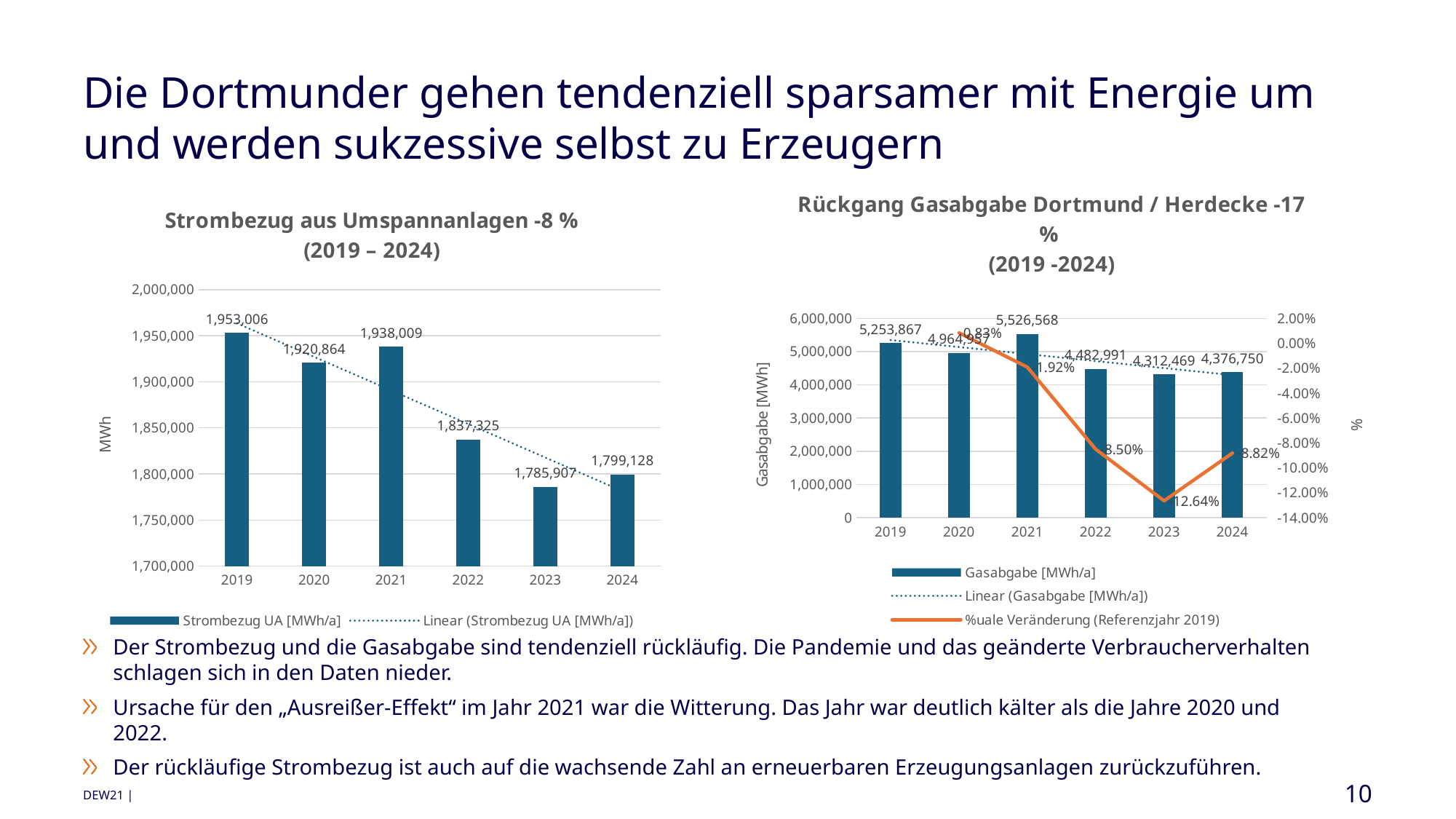
In the left chart 'Strombezug aus Umspannanlagen', what is the value for 2023? 1,785,907 In the left chart 'Strombezug aus Umspannanlagen', which year has the lowest value? 2023 In the right chart 'Rückgang Gasabgabe Dortmund / Herdecke', which year has the highest Gasabgabe bar? 2021 In the left chart 'Strombezug aus Umspannanlagen', what is the difference between the 2019 and 2024 values? 153,878 In the left chart 'Strombezug aus Umspannanlagen', which year has the highest value? 2019 In the right chart 'Rückgang Gasabgabe Dortmund / Herdecke', what is the Gasabgabe value for 2021? 5,526,568 How many series does the legend of the right chart 'Rückgang Gasabgabe Dortmund / Herdecke' list? 3 In the right chart 'Rückgang Gasabgabe Dortmund / Herdecke', is the Gasabgabe bar for 2022 or for 2024 larger? 2022 In the left chart 'Strombezug aus Umspannanlagen', what is the value for 2019? 1,953,006 How many years are shown on the x axis of the left chart 'Strombezug aus Umspannanlagen'? 6 In the right chart 'Rückgang Gasabgabe Dortmund / Herdecke', what is the percentage change value shown for 2023? -12.64% What kind of chart is the left chart, 'Strombezug aus Umspannanlagen -8 %'? bar chart